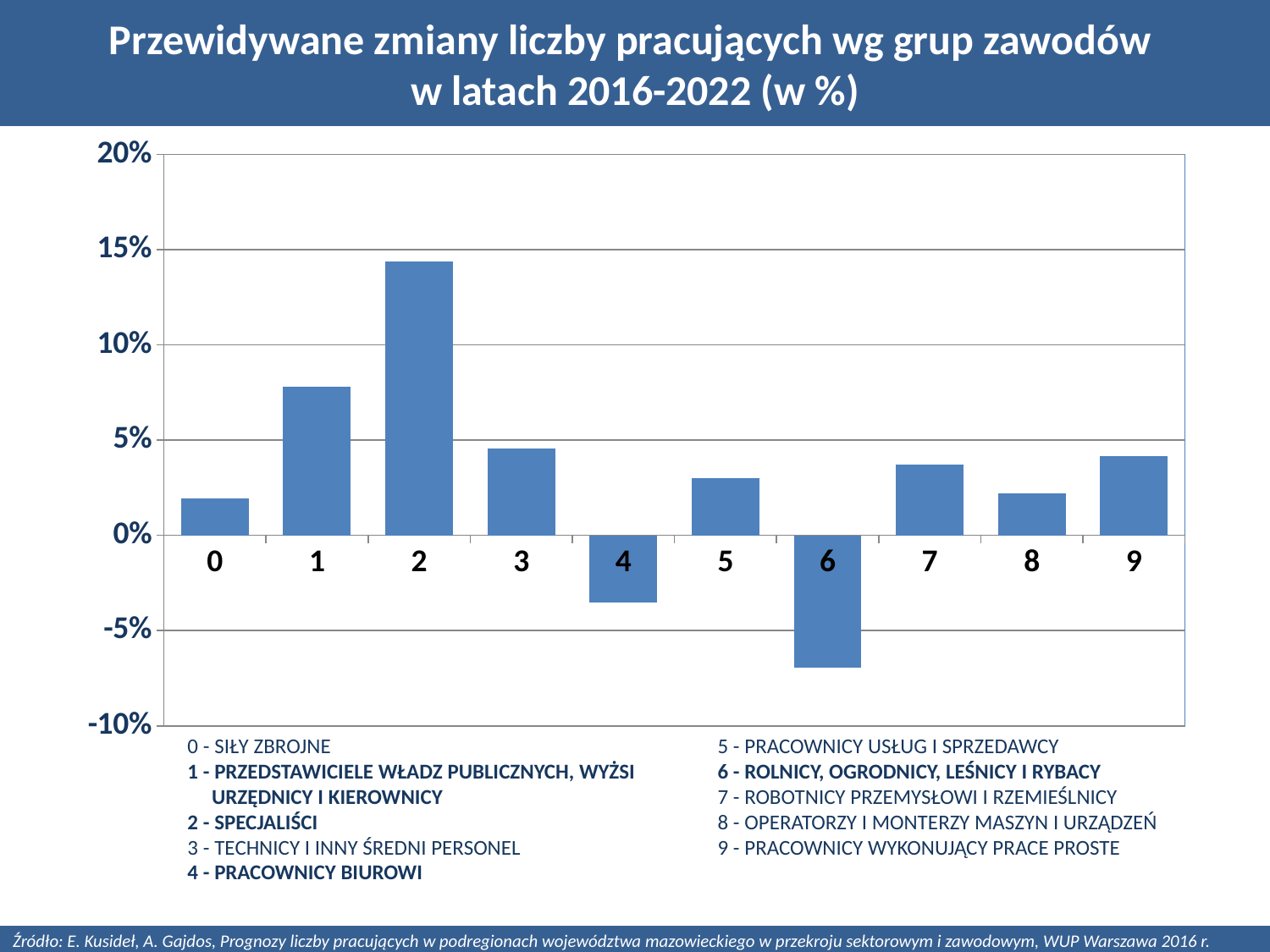
Which has the larger value, group 4 or group 6? 4 Is the value for group 6 greater or less than -5%? less Which has the larger value, group 1 or group 3? 1 How many groups show a negative predicted change? 2 Which occupational group has the lowest predicted change? 6 Is the value for group 2 greater or less than 10%? greater According to the legend, which occupational group is labelled 2? SPECJALIŚCI Is the value for group 0 greater or less than 5%? less What kind of chart is shown on the slide? bar chart How many occupational groups (bars) are plotted on the chart? 10 Which occupational group has the highest predicted change? 2